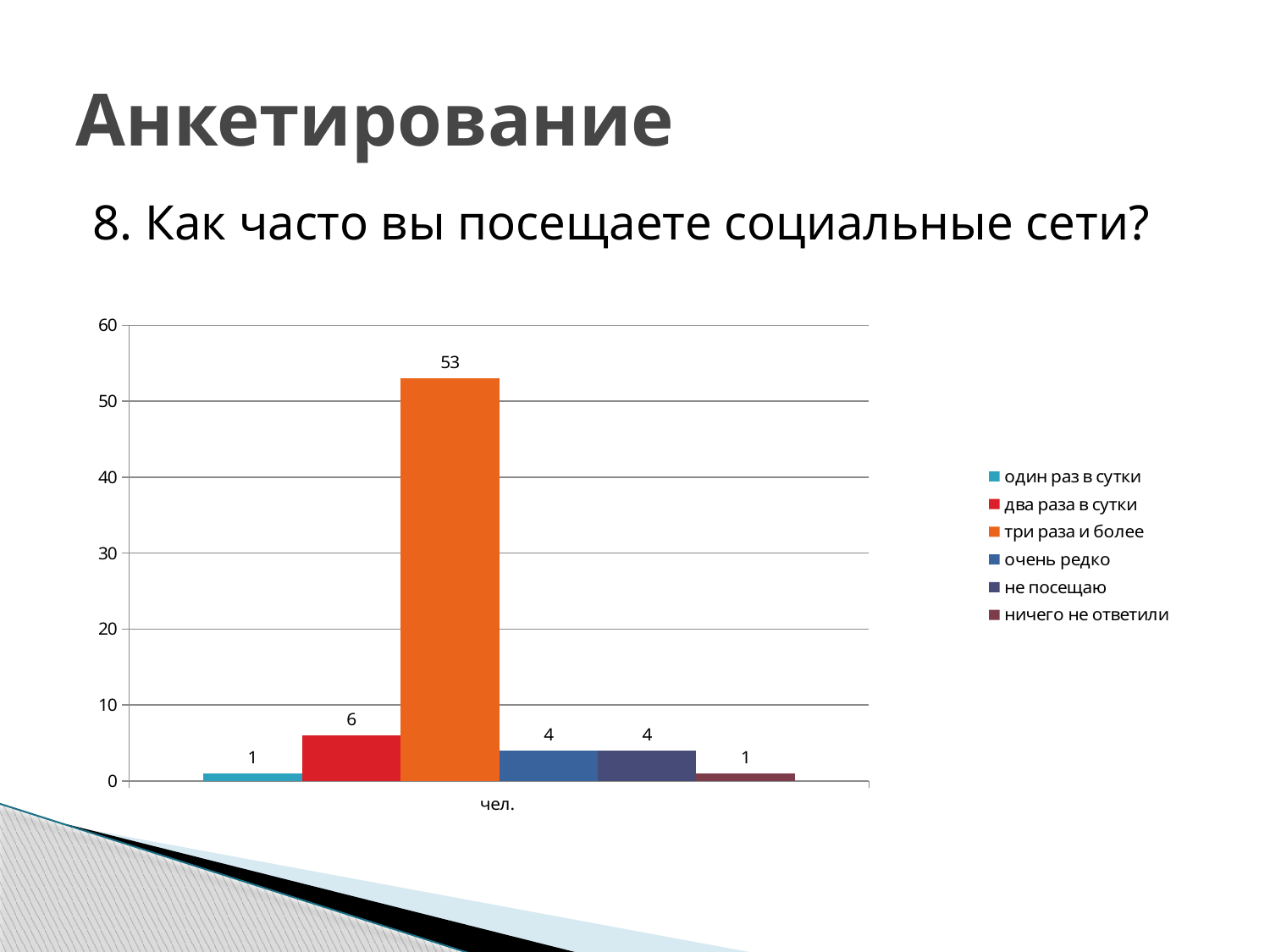
Which series has the highest value? три раза и более What value is shown for "очень редко"? 4 What is the difference between the values for "три раза и более" and "два раза в сутки"? 47 What kind of chart is shown on the slide? bar chart What value is shown for "два раза в сутки"? 6 What value is shown for "три раза и более"? 53 Which is larger, the value for "два раза в сутки" or the value for "не посещаю"? два раза в сутки How many series does the legend list? 6 Is the value for "три раза и более" greater or less than 50? greater What value is shown for "один раз в сутки"? 1 What is the label shown on the x axis of the chart? чел. What colour is the bar for "три раза и более"? orange